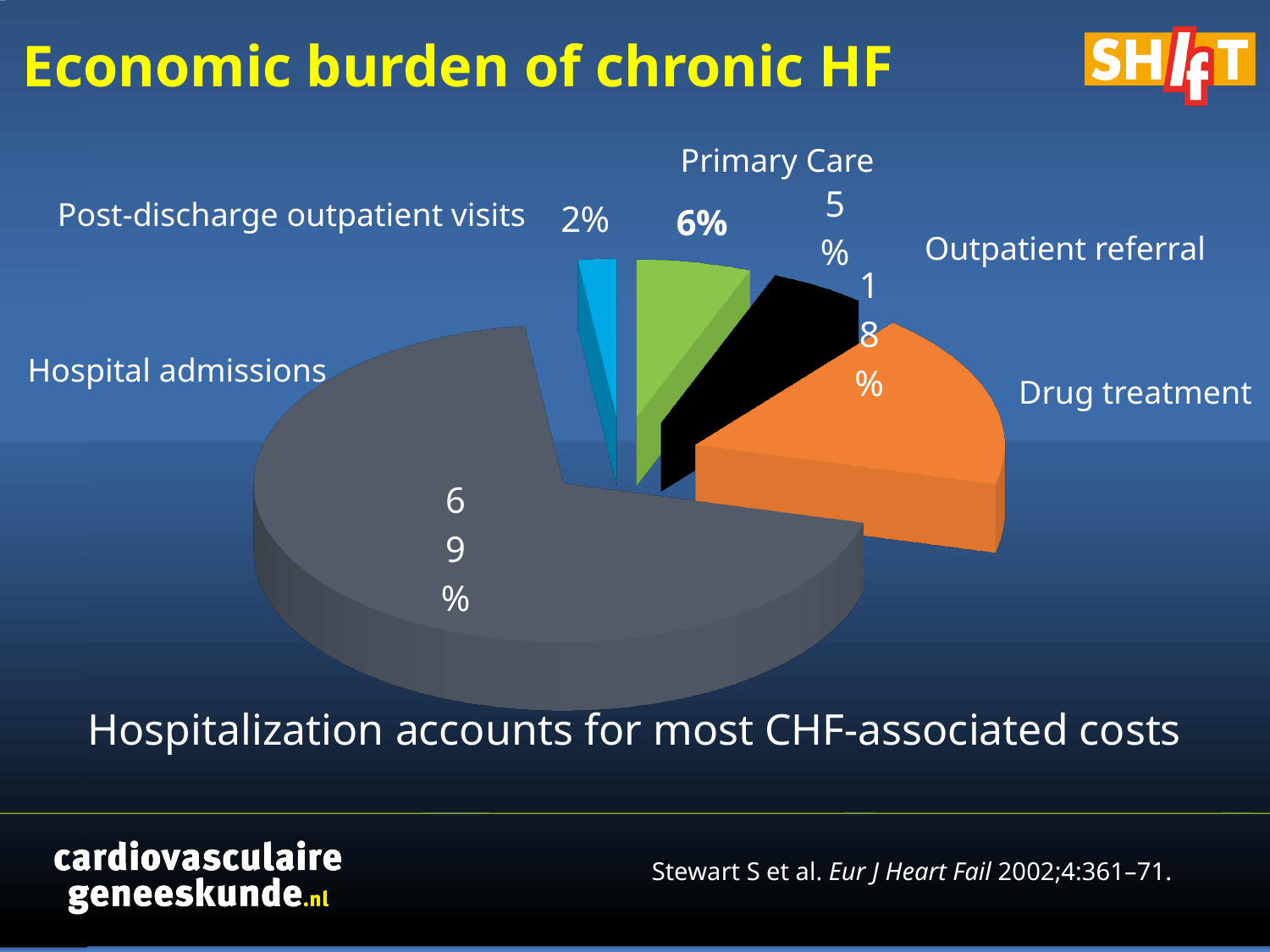
What kind of chart is shown on the slide? pie chart Which is larger, the share for Primary Care or the share for Outpatient referral? Primary Care What share of costs is attributed to Primary Care? 6% Which category accounts for the largest share of the pie? Hospital admissions What share of costs is attributed to Hospital admissions? 69% What is the title of the slide containing the pie chart? Economic burden of chronic HF What share of costs is attributed to Post-discharge outpatient visits? 2% How many categories are shown in the pie chart? 5 Which category accounts for the smallest share of the pie? Post-discharge outpatient visits What share of costs is attributed to Drug treatment? 18% What share of costs is attributed to Outpatient referral? 5% What is the difference in percentage points between Hospital admissions and Drug treatment? 51